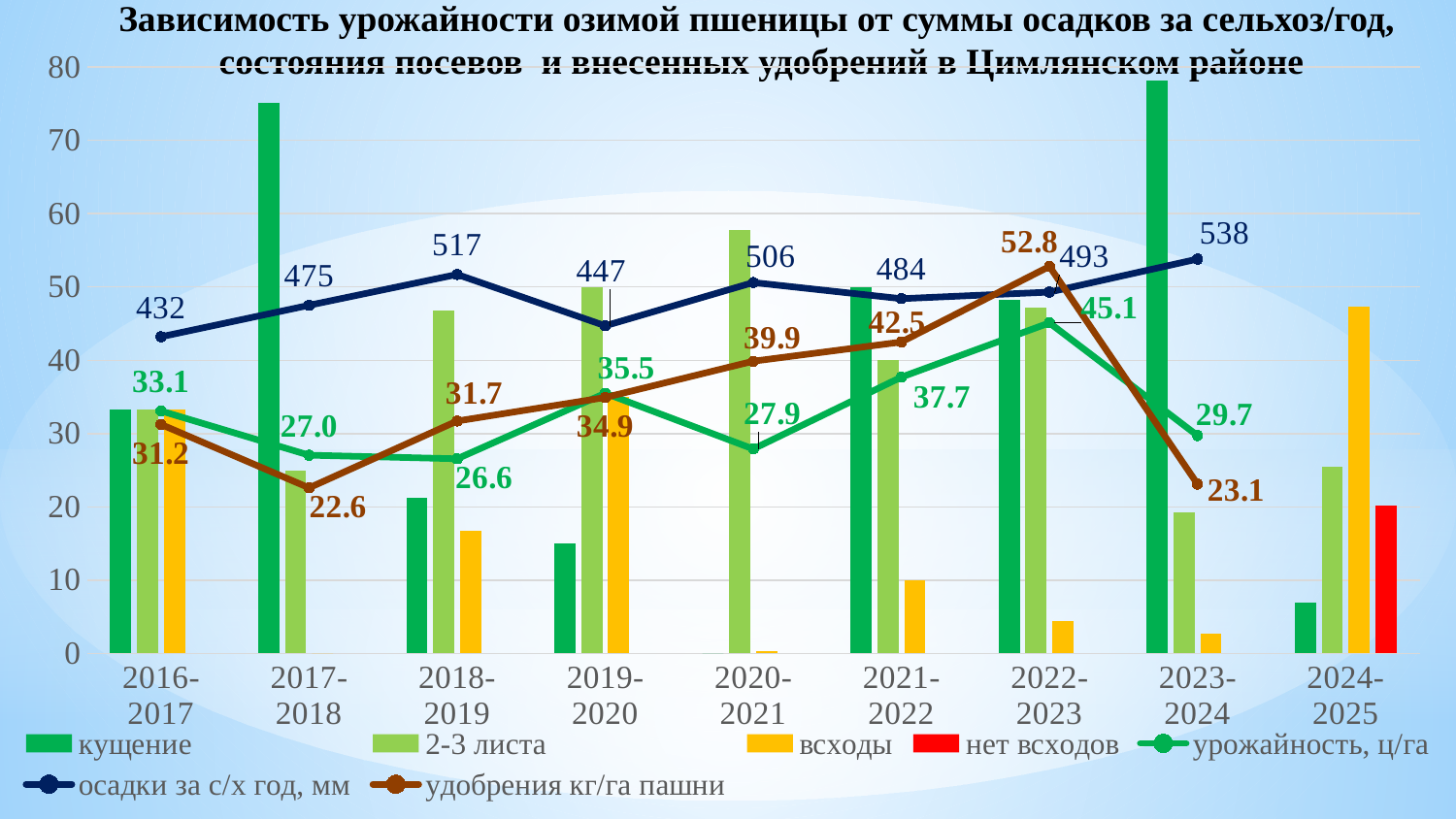
What is the value of осадки за с/х год, мм for 2018-2019? 517 Which season has the larger удобрения кг/га пашни value, 2020-2021 or 2021-2022? 2021-2022 Is the кущение bar for 2017-2018 greater or less than 70? greater How many series does the legend list? 7 What is the difference between осадки за с/х год, мм in 2023-2024 and in 2016-2017? 106 How many seasons are shown on the x axis? 9 In which season is удобрения кг/га пашни the highest? 2022-2023 What kind of chart is shown on the slide? Combined bar and line chart In which season is урожайность, ц/га the lowest? 2018-2019 In which season is осадки за с/х год, мм the highest? 2023-2024 What is the урожайность, ц/га value for 2022-2023? 45.1 What is the удобрения кг/га пашни value for 2017-2018? 22.6